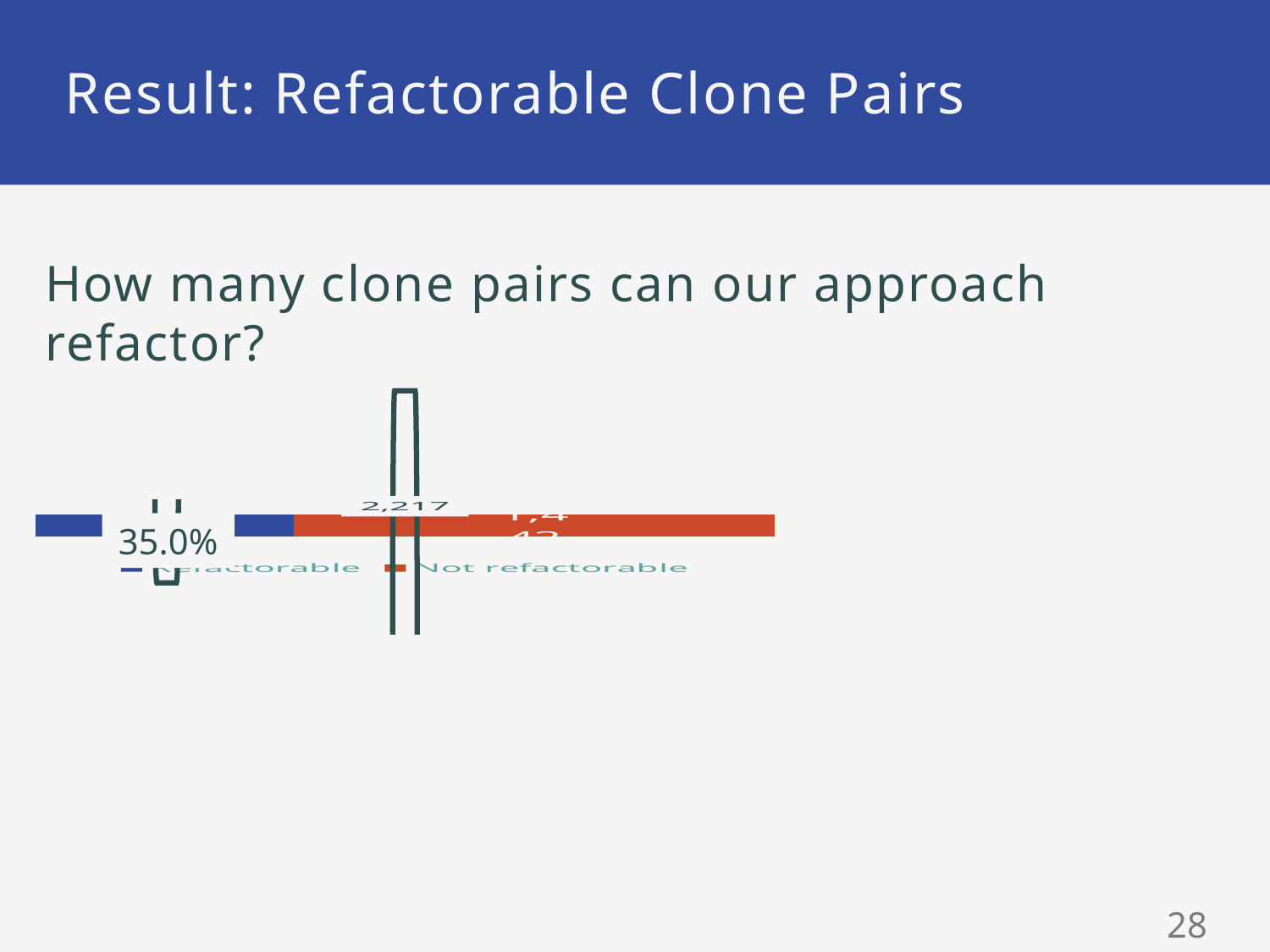
What data label is printed above the stacked bar in the chart? 2,217 Which segment of the stacked bar is longer, the blue 'Refactorable' segment or the red 'Not refactorable' segment? Not refactorable What is the second legend entry in the chart? Not refactorable How many series does the chart's legend list? 2 What colour represents the 'Not refactorable' series in the chart? red What kind of chart is shown on the slide? bar chart